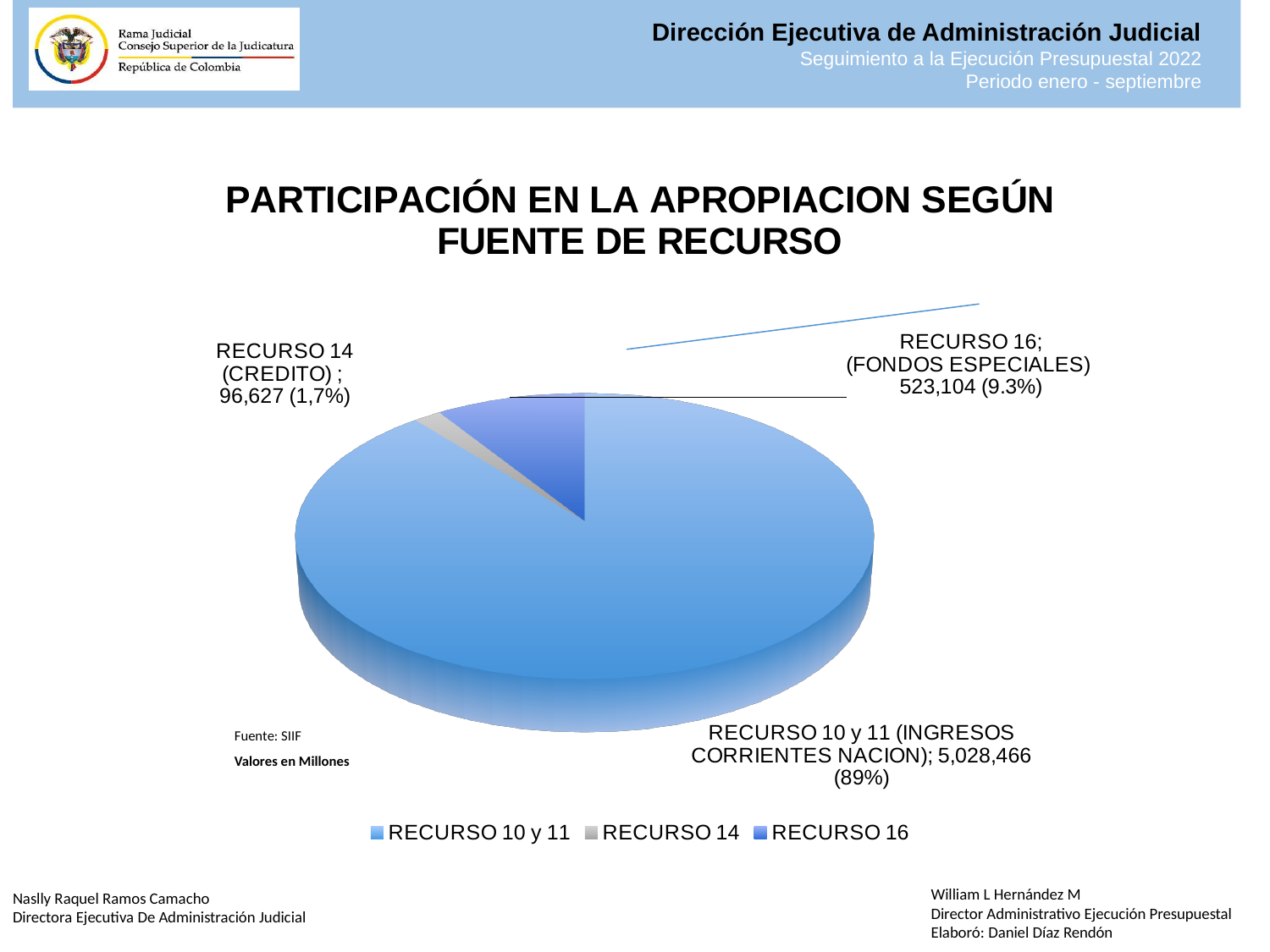
Which source of resources has the largest slice of the pie? RECURSO 10 y 11 (INGRESOS CORRIENTES NACION) What is the value shown for RECURSO 16 (FONDOS ESPECIALES)? 523,104 What is the title of the chart? PARTICIPACIÓN EN LA APROPIACION SEGÚN FUENTE DE RECURSO What is the value shown for RECURSO 14 (CREDITO)? 96,627 What is the value shown for RECURSO 10 y 11 (INGRESOS CORRIENTES NACION)? 5,028,466 What type of chart is shown on the slide? Pie chart How many entries does the legend list? 3 What share of the pie does RECURSO 10 y 11 (INGRESOS CORRIENTES NACION) represent? 89% How many slices does the pie chart have? 3 Which source of resources has the smallest slice of the pie? RECURSO 14 (CREDITO) What is the difference between the values for RECURSO 16 (FONDOS ESPECIALES) and RECURSO 14 (CREDITO)? 426,477 What share of the pie does RECURSO 16 (FONDOS ESPECIALES) represent? 9.3%